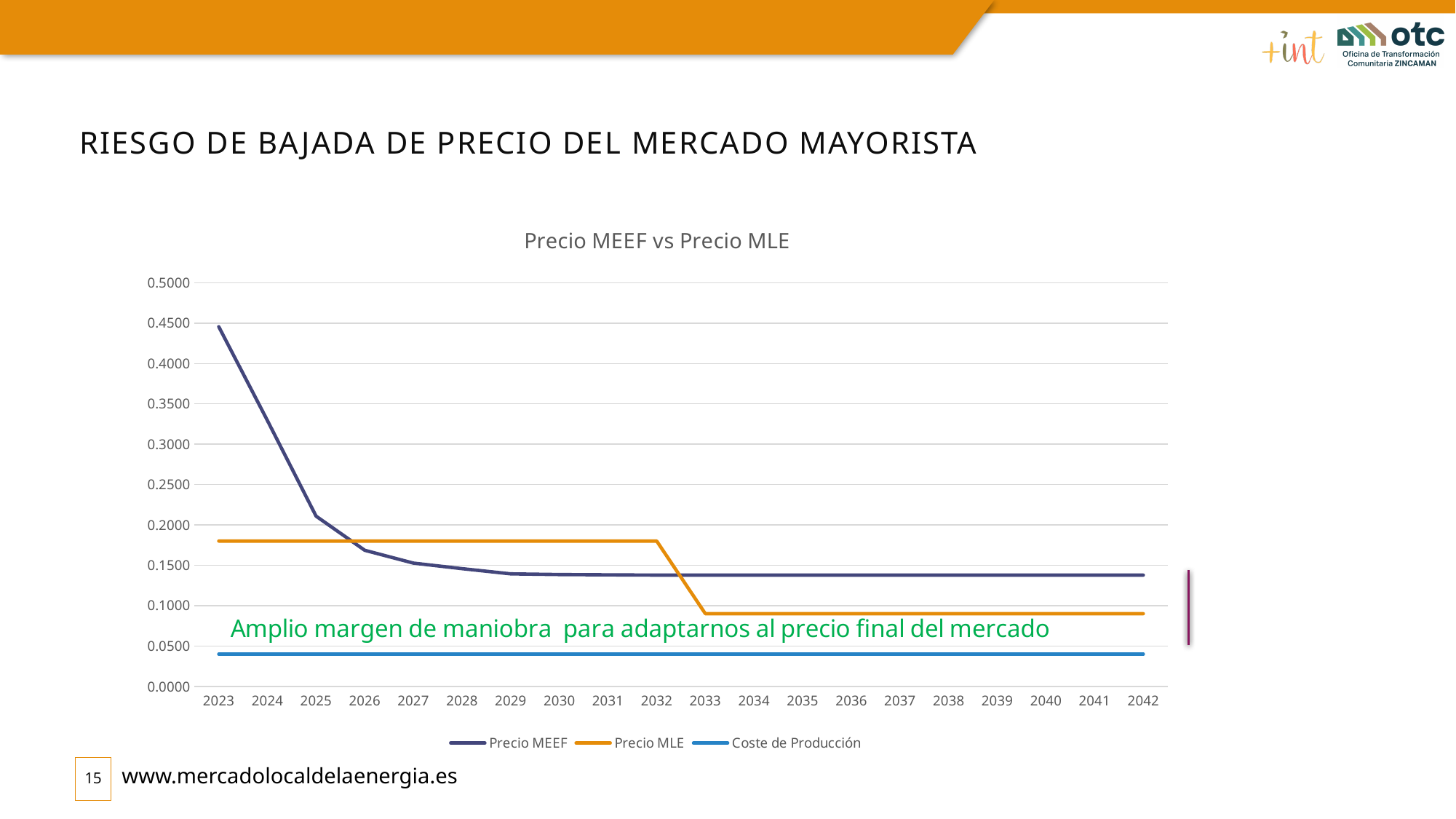
Does the Precio MEEF line rise or fall from 2023 to 2042? fall How many series does the legend list? 3 In 2036, which is higher: Precio MEEF or Precio MLE? Precio MEEF Is the value for Precio MEEF in 2042 greater or less than 0.1000? greater What kind of chart is shown on the slide? line chart Is the value for Precio MLE in 2023 greater or less than 0.2000? less How many years are shown on the x axis? 20 In 2030, which is higher: Precio MEEF or Precio MLE? Precio MLE Is the value for Coste de Producción in 2030 greater or less than 0.0500? less Which series has the lowest values across all years? Coste de Producción What is the title of the chart? Precio MEEF vs Precio MLE